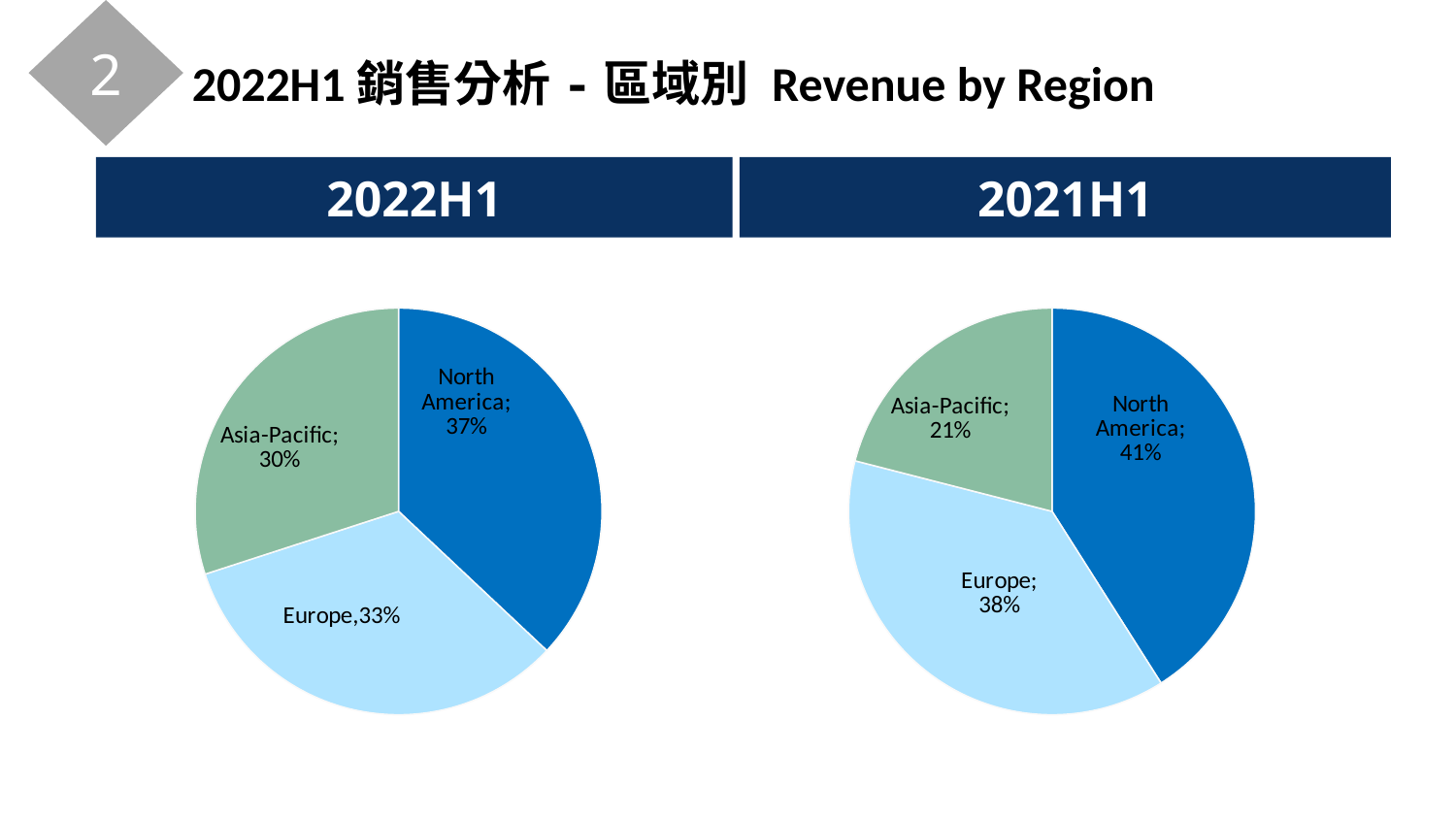
What type of chart is used for 2022H1? Pie chart In the 2022H1 pie chart, what is the difference between the North America and Asia-Pacific shares? 7% In the 2022H1 pie chart, what share does North America have? 37% In the 2022H1 pie chart, what share does Europe have? 33% In the 2021H1 pie chart, which region has the largest share? North America In the 2021H1 pie chart, which is larger, Europe or North America? North America In the 2022H1 pie chart, which region has the smallest share? Asia-Pacific In the 2021H1 pie chart, what is the difference between the Europe and Asia-Pacific shares? 17% In the 2022H1 pie chart, what share does Asia-Pacific have? 30% In the 2021H1 pie chart, which region has the smallest share? Asia-Pacific In the 2021H1 pie chart, what share does Asia-Pacific have? 21% In the 2021H1 pie chart, what share does North America have? 41%